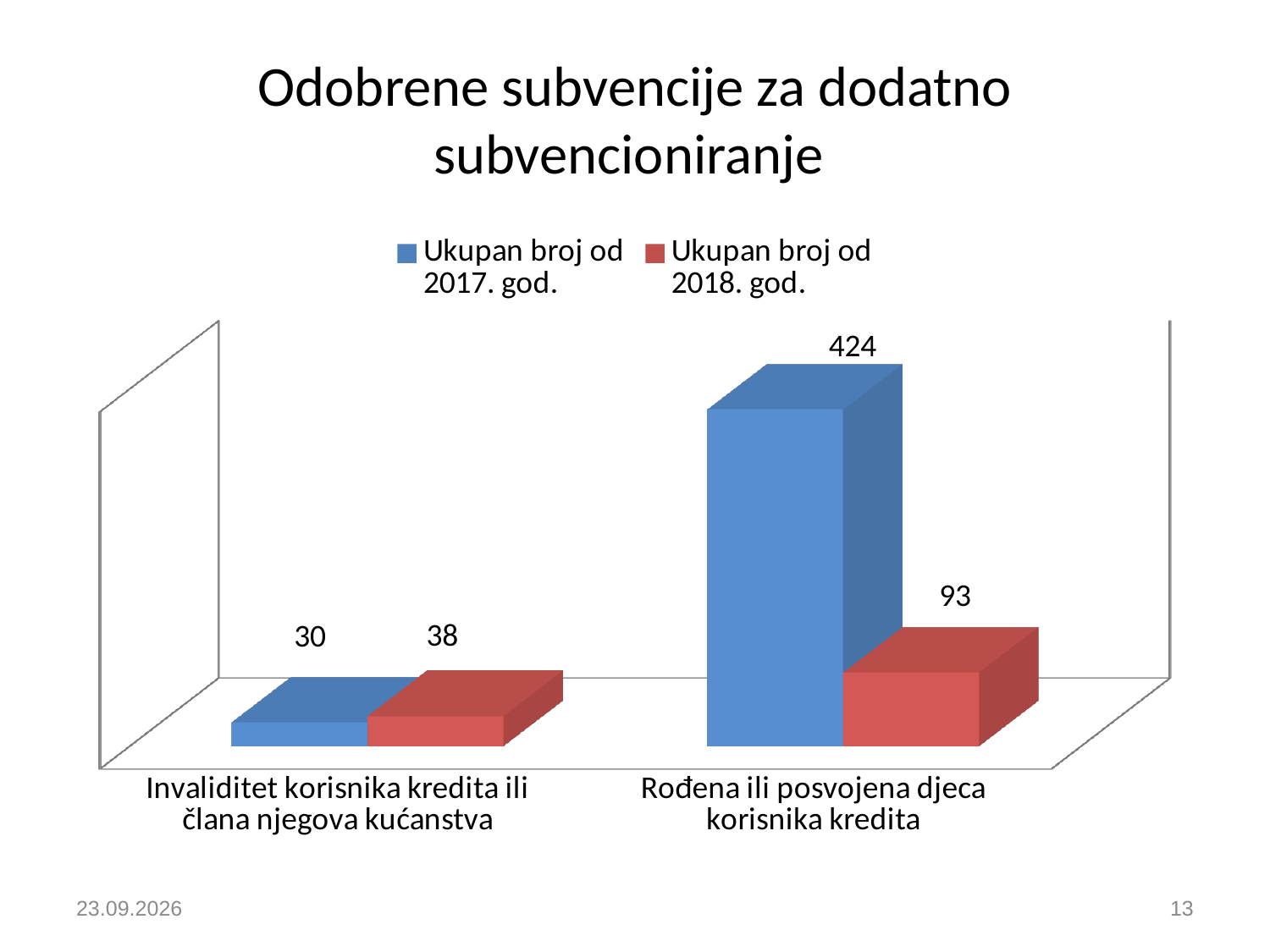
What is the value for 'Ukupan broj od 2017. god.' in the category 'Invaliditet korisnika kredita ili člana njegova kućanstva'? 30 What is the value for 'Ukupan broj od 2018. god.' in the category 'Invaliditet korisnika kredita ili člana njegova kućanstva'? 38 What is the value for 'Ukupan broj od 2018. god.' in the category 'Rođena ili posvojena djeca korisnika kredita'? 93 What kind of chart is shown on the slide? Bar chart What is the value for 'Ukupan broj od 2017. god.' in the category 'Rođena ili posvojena djeca korisnika kredita'? 424 What is the difference between the 2018 and 2017 values for 'Invaliditet korisnika kredita ili člana njegova kućanstva'? 8 What is the difference between the 2017 and 2018 values for 'Rođena ili posvojena djeca korisnika kredita'? 331 For 'Invaliditet korisnika kredita ili člana njegova kućanstva', which series has the larger value, 'Ukupan broj od 2017. god.' or 'Ukupan broj od 2018. god.'? Ukupan broj od 2018. god. How many categories are shown on the x axis of the chart? 2 How many series does the legend list? 2 Which category has the highest value for 'Ukupan broj od 2017. god.'? Rođena ili posvojena djeca korisnika kredita Which category has the lowest value for 'Ukupan broj od 2018. god.'? Invaliditet korisnika kredita ili člana njegova kućanstva